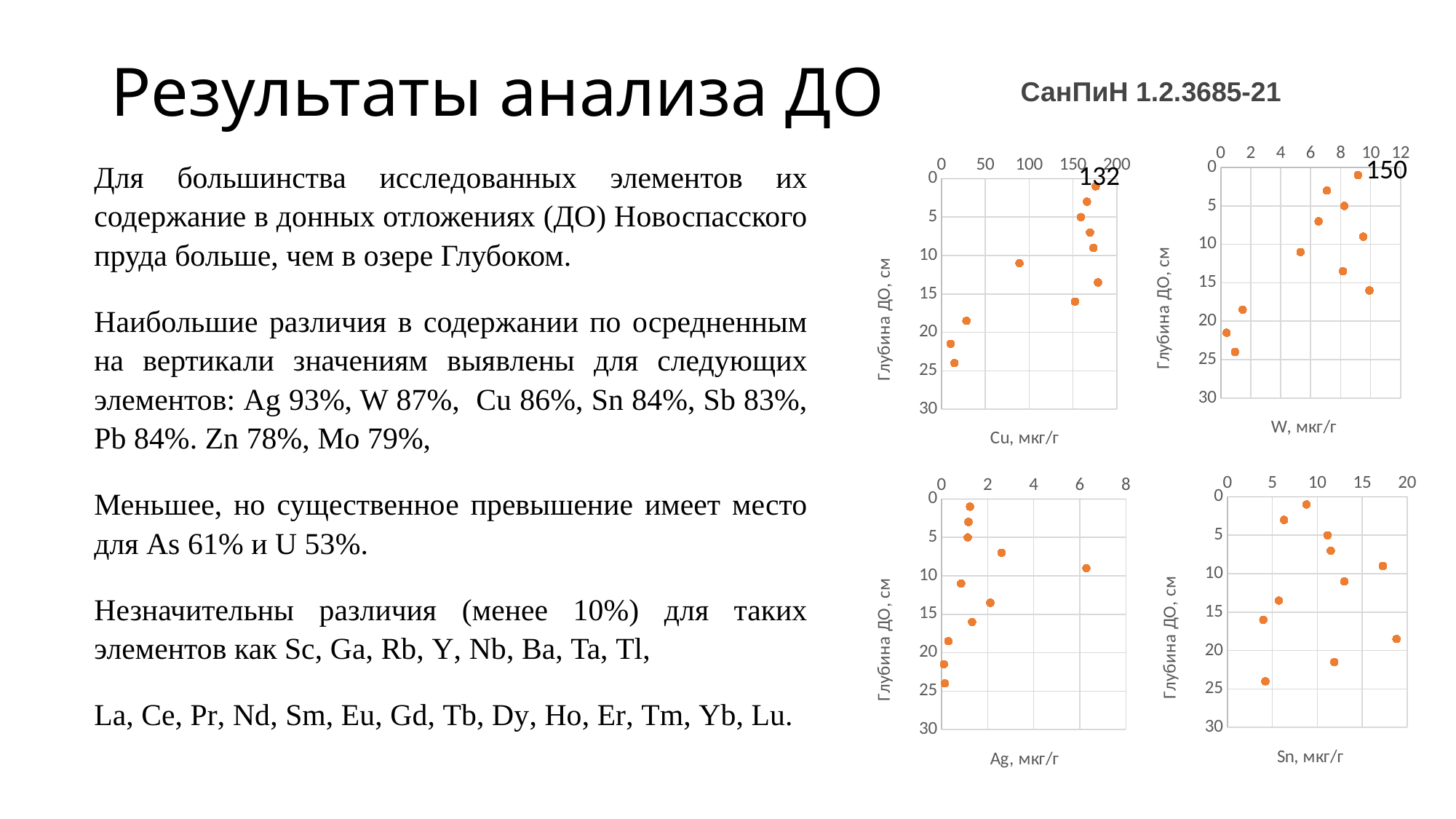
In the 'Cu, мкг/г' chart, is the value for the point at a depth of about 11 cm greater or less than 100? less In the 'Cu, мкг/г' chart, which has the larger Cu value: the point at a depth of about 1 cm or the point at a depth of about 24 cm? the point at about 1 cm In the 'W, мкг/г' chart, is the value for the point at a depth of about 24 cm greater or less than 2? less What number is annotated at the top of the 'W, мкг/г' chart? 150 In the 'Cu, мкг/г' chart, is the value for the point at a depth of about 24 cm greater or less than 50? less What is the y-axis title of the 'W, мкг/г' chart? Глубина ДО, см What number is annotated at the top of the 'Cu, мкг/г' chart? 132 How many charts are shown on the slide? 4 What kind of chart is the 'Cu, мкг/г' chart? scatter chart